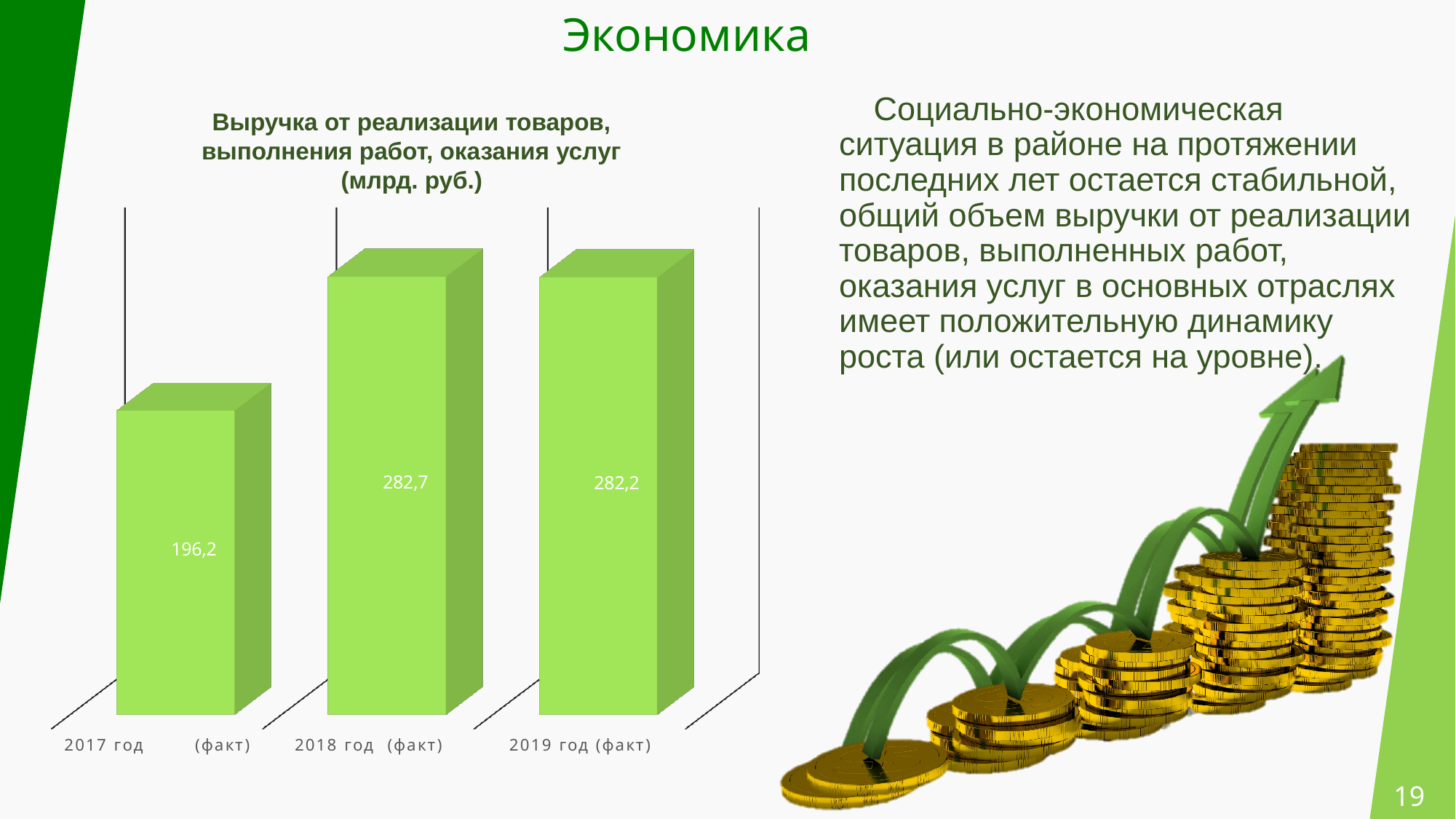
In what units are the chart values expressed, according to the chart title? млрд. руб. Which is larger, the revenue value for 2017 год (факт) or for 2019 год (факт)? 2019 год (факт) How many years (categories) are shown in the chart? 3 What is the revenue value shown for 2018 год (факт)? 282,7 What is the difference between the revenue values for 2018 год (факт) and 2019 год (факт)? 0,5 Which year has the lowest revenue value in the chart? 2017 год (факт) What is the revenue value shown for 2017 год (факт)? 196,2 What kind of chart is used to show the revenue data? Bar chart Which year has the highest revenue value in the chart? 2018 год (факт) What is the difference between the revenue values for 2018 год (факт) and 2017 год (факт)? 86,5 What is the revenue value shown for 2019 год (факт)? 282,2 Does the revenue value rise or fall from 2017 год (факт) to 2018 год (факт)? Rise